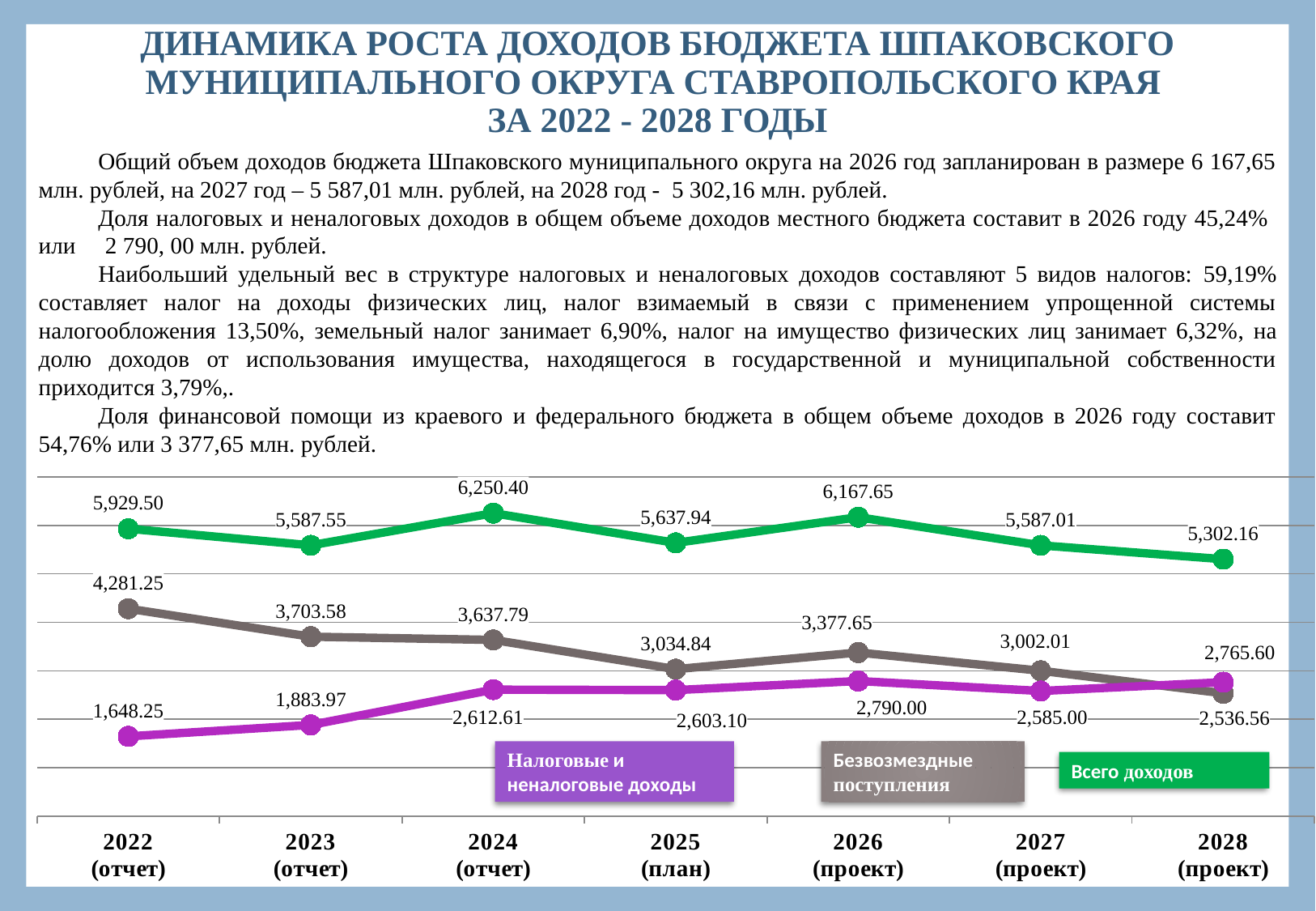
What is the value of Налоговые и неналоговые доходы for 2022 (отчет)? 1,648.25 Which is larger in 2028 (проект): Налоговые и неналоговые доходы or Безвозмездные поступления? Налоговые и неналоговые доходы What is the value of Безвозмездные поступления for 2026 (проект)? 3,377.65 What is the value of Всего доходов for 2024 (отчет)? 6,250.40 In which year is Всего доходов at its highest? 2024 (отчет) What type of chart is shown on the slide? line chart In which year is Налоговые и неналоговые доходы at its lowest? 2022 (отчет) Which colour is used for the Всего доходов series in the chart? green What is the difference between Всего доходов in 2026 (проект) and in 2028 (проект)? 865.49 Does Безвозмездные поступления generally rise or fall from 2022 to 2028? fall How many years (categories) are plotted along the x axis of the chart? 7 How many series does the chart's legend list? 3